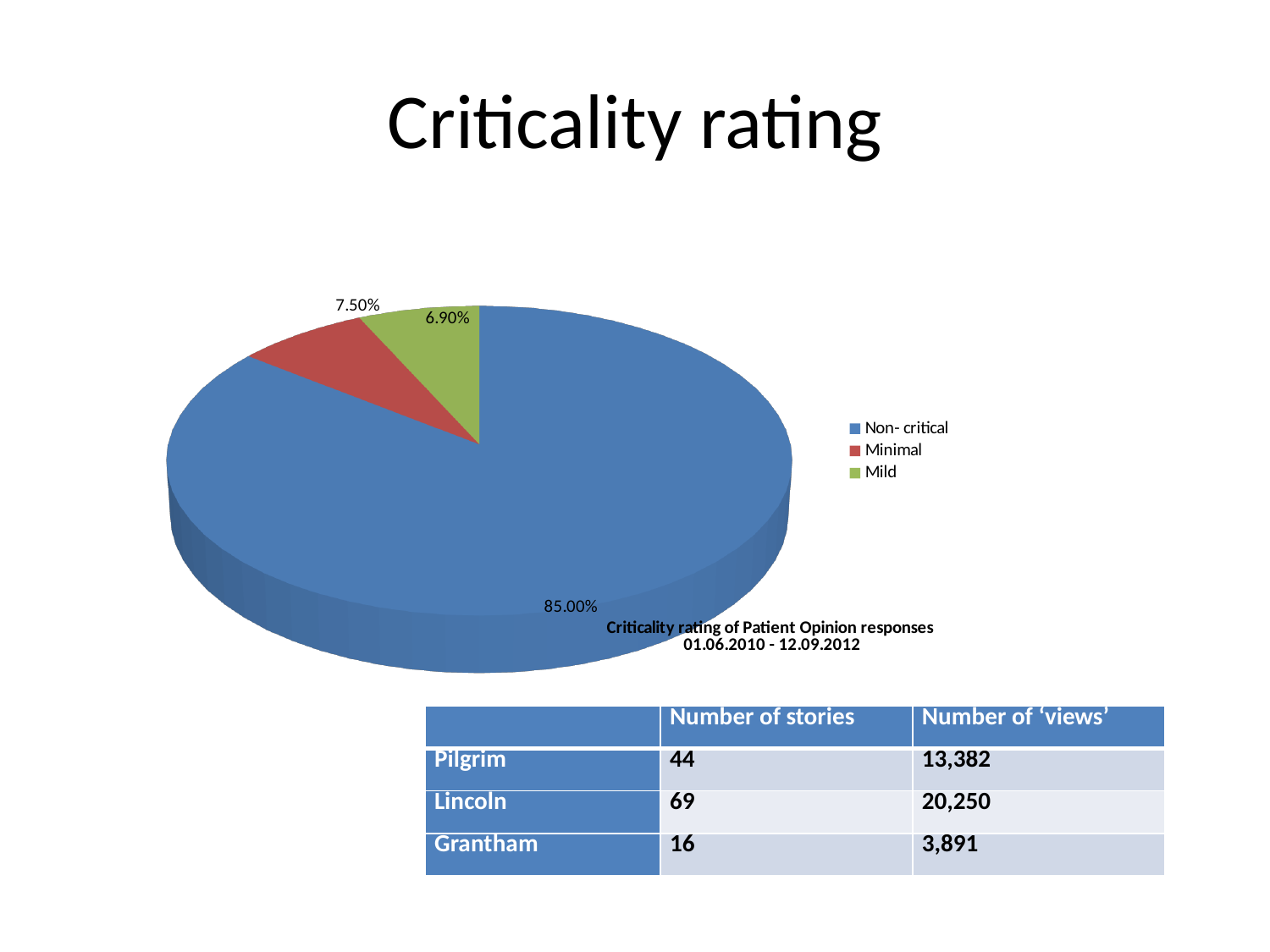
Which category has the smallest slice of the pie? Mild What colour is the Mild slice in the pie chart? Green How many entries does the chart legend list? 3 How many slices does the pie chart have? 3 What is the difference in percentage points between the Non- critical and Minimal slices? 77.50% What is the difference in percentage points between the Minimal and Mild slices? 0.60% What is the title of the pie chart? Criticality rating of Patient Opinion responses 01.06.2010 - 12.09.2012 What share of the pie does the Minimal slice represent? 7.50% What share of the pie does the Non- critical slice represent? 85.00% What kind of chart is shown on the slide? Pie chart What share of the pie does the Mild slice represent? 6.90% Which category has the largest slice of the pie? Non- critical